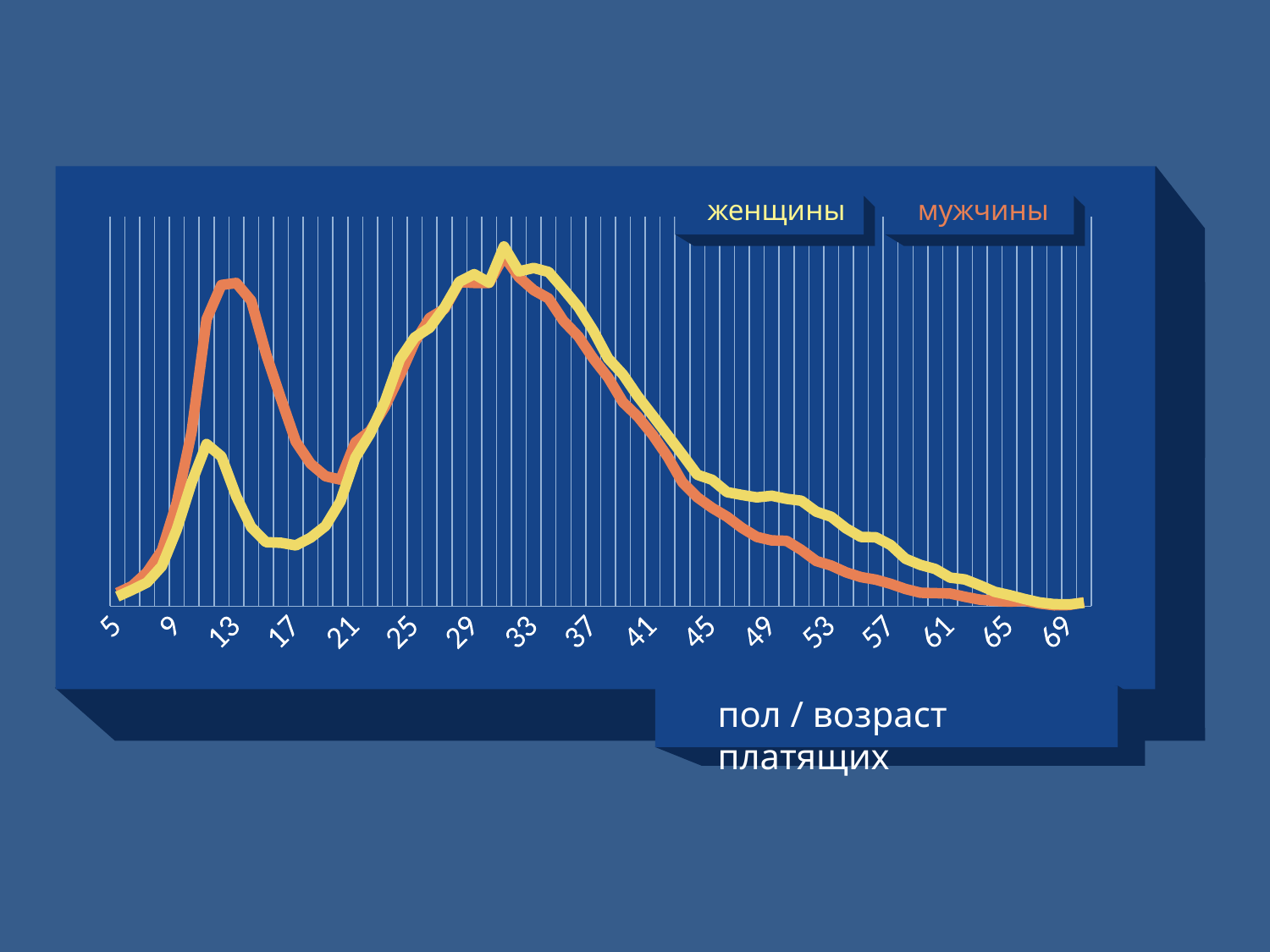
At age 49, which series has the higher value, женщины or мужчины? женщины At age 13, which series has the higher value, женщины or мужчины? мужчины Do the values for женщины rise or fall between age 17 and age 29? rise Do the values for мужчины rise or fall between age 33 and age 69? fall At age 17, which series has the higher value, женщины or мужчины? мужчины How many series does the legend list? 2 What is the first age label and the last age label on the x axis? 5 and 69 What kind of chart is shown on the slide? line chart What is the title of the chart? пол / возраст платящих How many age labels are shown on the x axis? 17 What are the two series named in the legend? женщины and мужчины